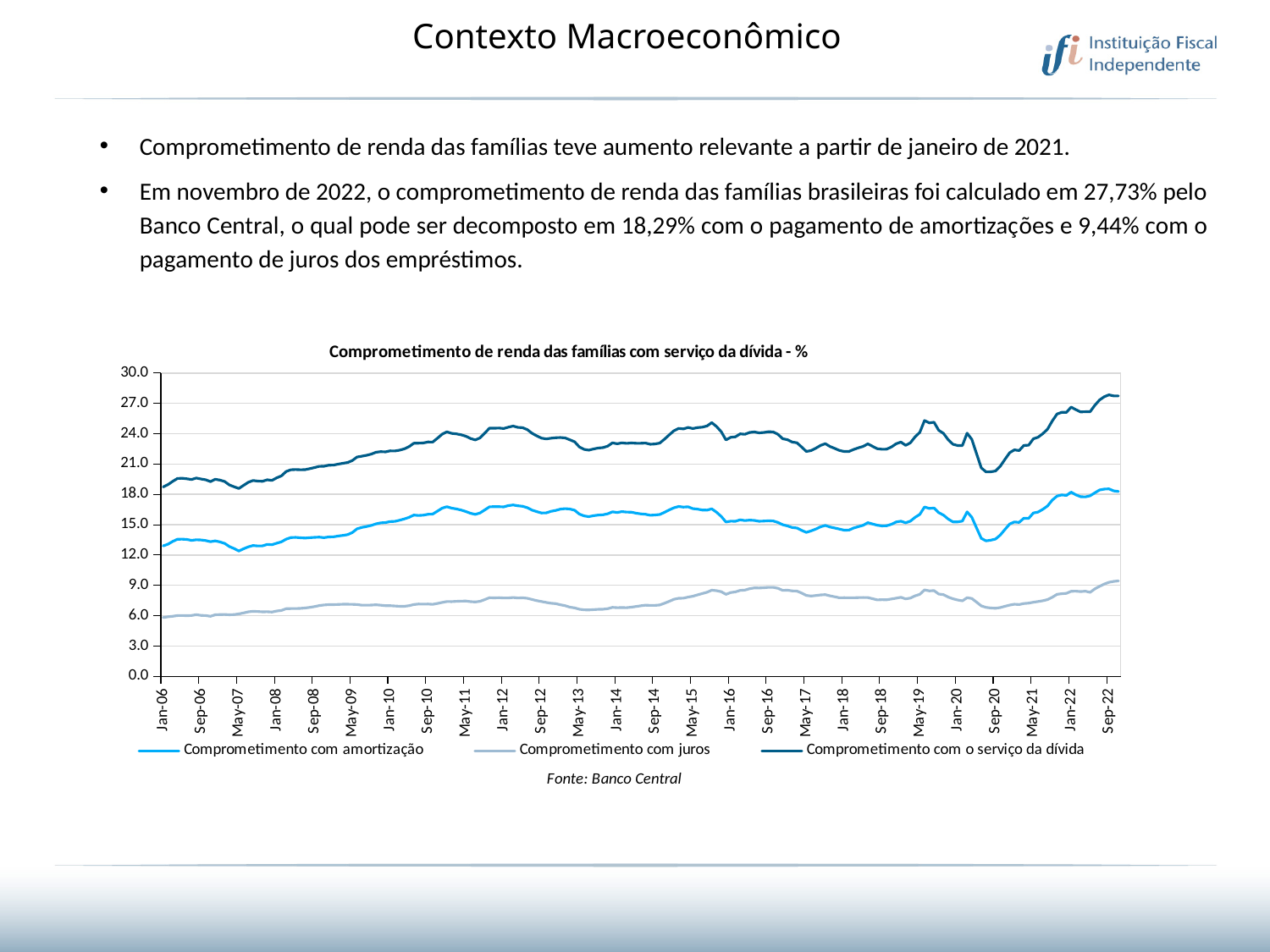
Is the value of Comprometimento com o serviço da dívida at Sep-20 greater or less than 24.0? less Which series has the lowest values across the whole period shown? Comprometimento com juros Does Comprometimento com o serviço da dívida rise or fall between Sep-20 and Sep-22? rise Which series has the highest values across the whole period shown? Comprometimento com o serviço da dívida Is the value of Comprometimento com juros at Jan-06 greater or less than 9.0? less What is the title of the chart? Comprometimento de renda das famílias com serviço da dívida - % Is the value of Comprometimento com amortização at Jan-06 greater or less than 15.0? less What kind of chart is shown on the slide? line chart What source is cited below the chart? Banco Central At Sep-22, which is larger: Comprometimento com amortização or Comprometimento com juros? Comprometimento com amortização How many series does the legend of the chart list? 3